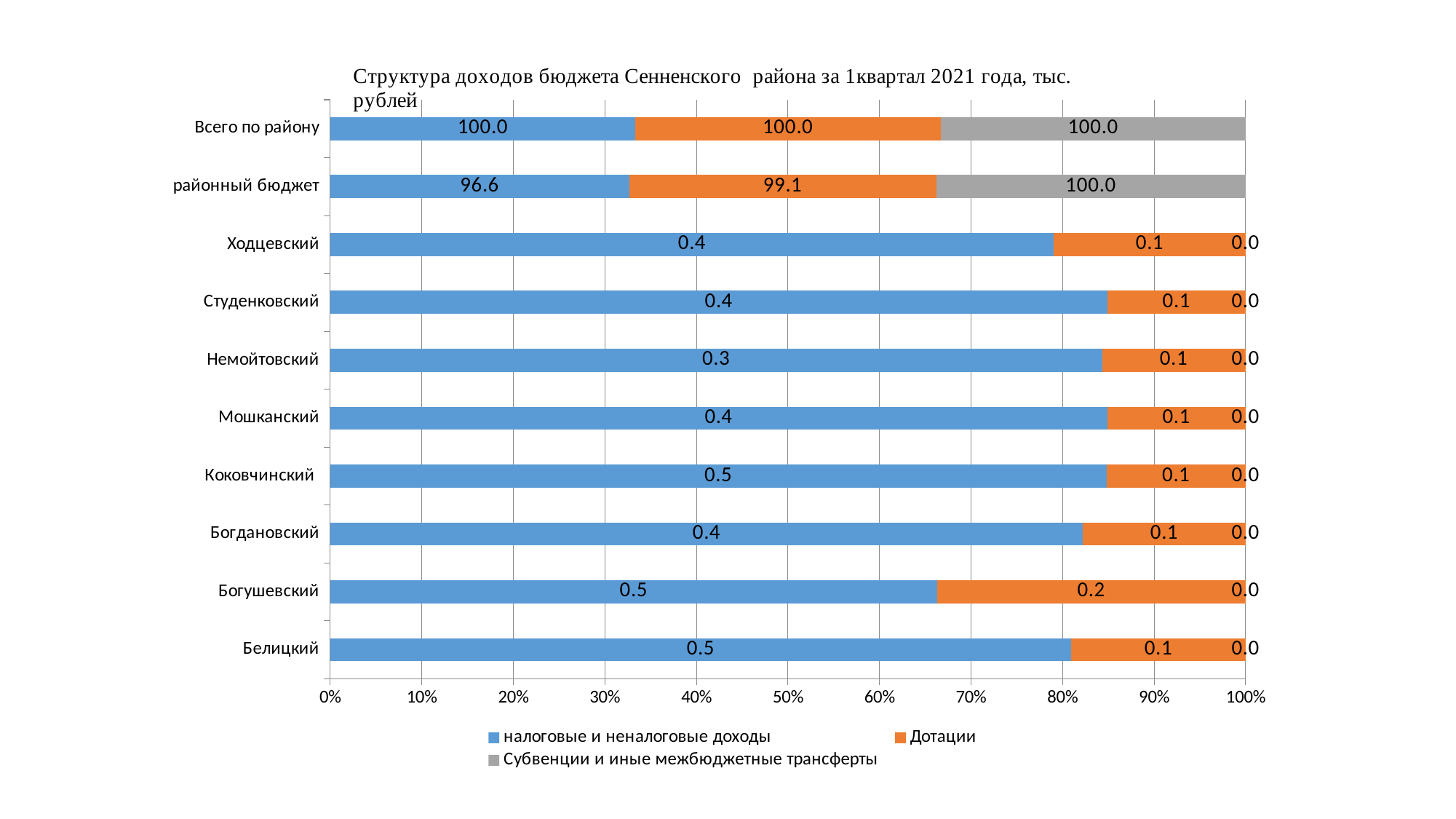
Is the share of the bar taken by 'налоговые и неналоговые доходы' for 'Богушевский' greater or less than 70%? less How many categories are listed on the vertical axis of the chart? 10 How many series does the legend list? 3 What is the value of 'налоговые и неналоговые доходы' for 'районный бюджет'? 96.6 Which colour represents 'Субвенции и иные межбюджетные трансферты' in the chart? grey What is the value of 'налоговые и неналоговые доходы' for 'Немойтовский'? 0.3 What is the difference between the 'Дотации' value and the 'налоговые и неналоговые доходы' value for 'районный бюджет'? 2.5 What is the title of the chart? Структура доходов бюджета Сенненского района за 1квартал 2021 года, тыс. рублей What is the value of 'Дотации' for 'районный бюджет'? 99.1 What kind of chart is shown on the slide? bar chart What is the value of 'Дотации' for 'Богушевский'? 0.2 Which has the larger 'Дотации' value, 'Богушевский' or 'Белицкий'? Богушевский